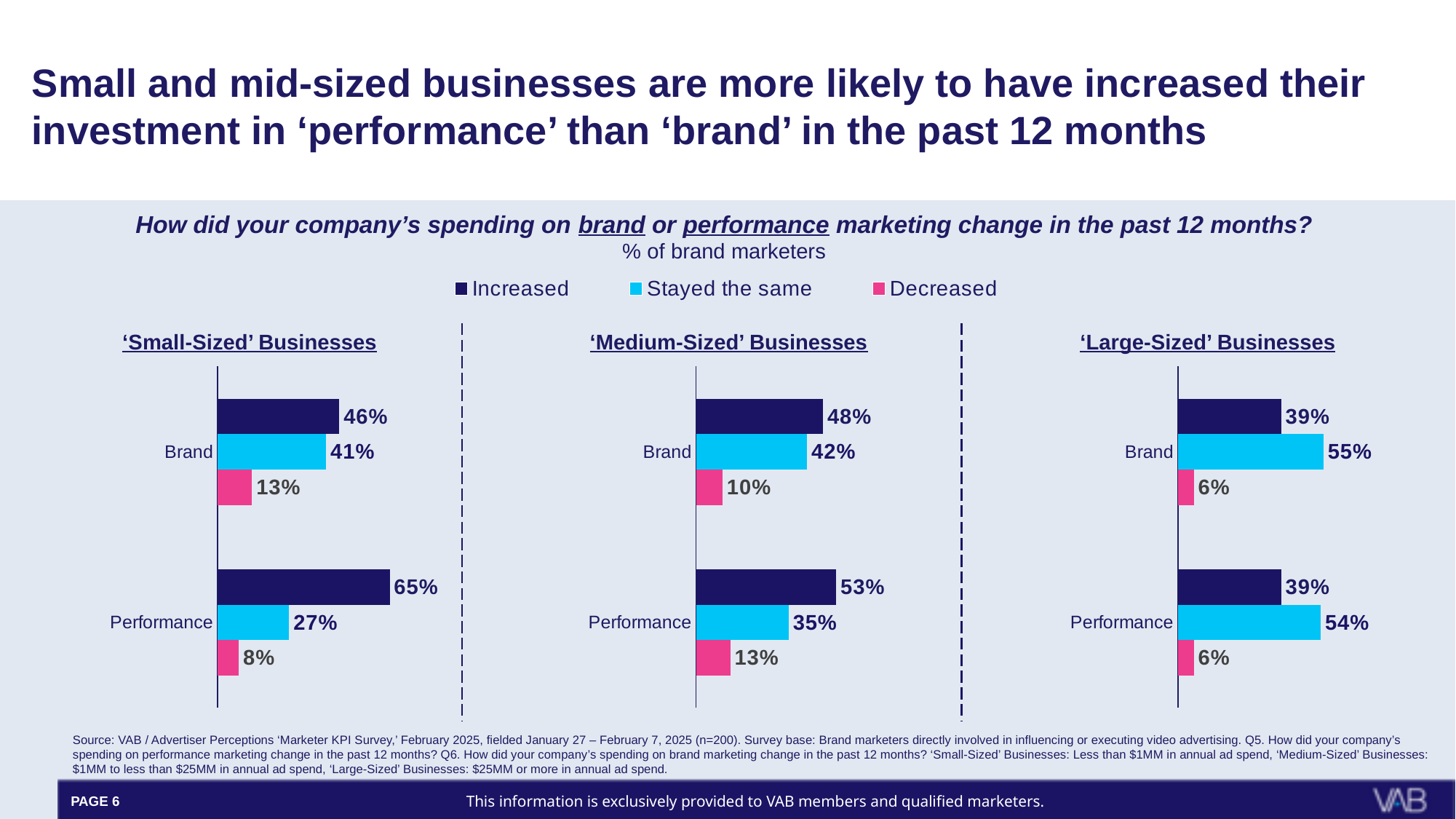
In the 'Medium-Sized' Businesses chart, what is the difference between the Decreased values for Performance and Brand? 3 percentage points In the 'Small-Sized' Businesses chart, what percentage of brand marketers said spending on Performance marketing increased? 65% What kind of chart is used for the 'Large-Sized' Businesses data? Bar chart In the 'Large-Sized' Businesses chart, which series has the highest value for Brand? Stayed the same How many categories are shown in the 'Medium-Sized' Businesses chart? 2 In the 'Medium-Sized' Businesses chart, what percentage said spending on Brand marketing stayed the same? 42% In the 'Medium-Sized' Businesses chart, which is larger: the Increased value for Brand or the Increased value for Performance? Performance Which colour represents the 'Decreased' series in the legend? Pink How many series does the legend list? 3 In the 'Small-Sized' Businesses chart, which series has the lowest value for Performance? Decreased In the 'Small-Sized' Businesses chart, what is the difference between the Increased values for Performance and Brand? 19 percentage points In the 'Large-Sized' Businesses chart, what percentage said spending on Performance marketing decreased? 6%